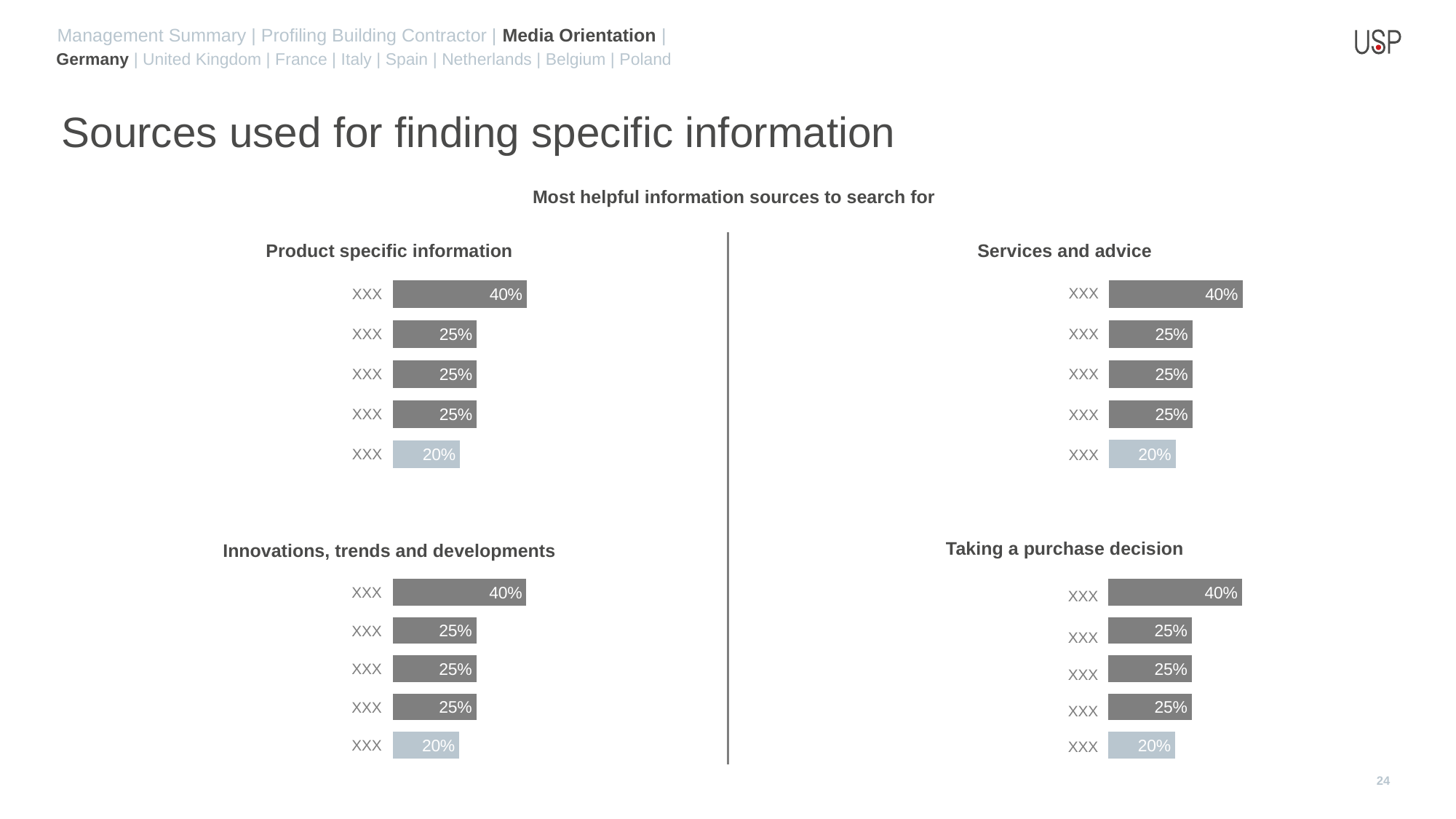
How many separate bar charts are shown on the slide? 4 What type of chart is used for 'Services and advice'? bar chart In the 'Services and advice' chart, what is the value of the bottom bar? 20% In the 'Taking a purchase decision' chart, what is the lowest value shown? 20% In the 'Product specific information' chart, what is the value of the top bar? 40% In the 'Innovations, trends and developments' chart, what is the highest value shown? 40% In the 'Product specific information' chart, how many bars have a value of 25%? 3 What is the overall heading above the four charts? Most helpful information sources to search for How many bars are shown in the 'Innovations, trends and developments' chart? 5 In the 'Taking a purchase decision' chart, which is larger: the top bar or the bottom bar? the top bar In the 'Product specific information' chart, what is the difference between the top bar and the bottom bar? 20% In the 'Services and advice' chart, what is the difference between the top bar (40%) and the second bar (25%)? 15%